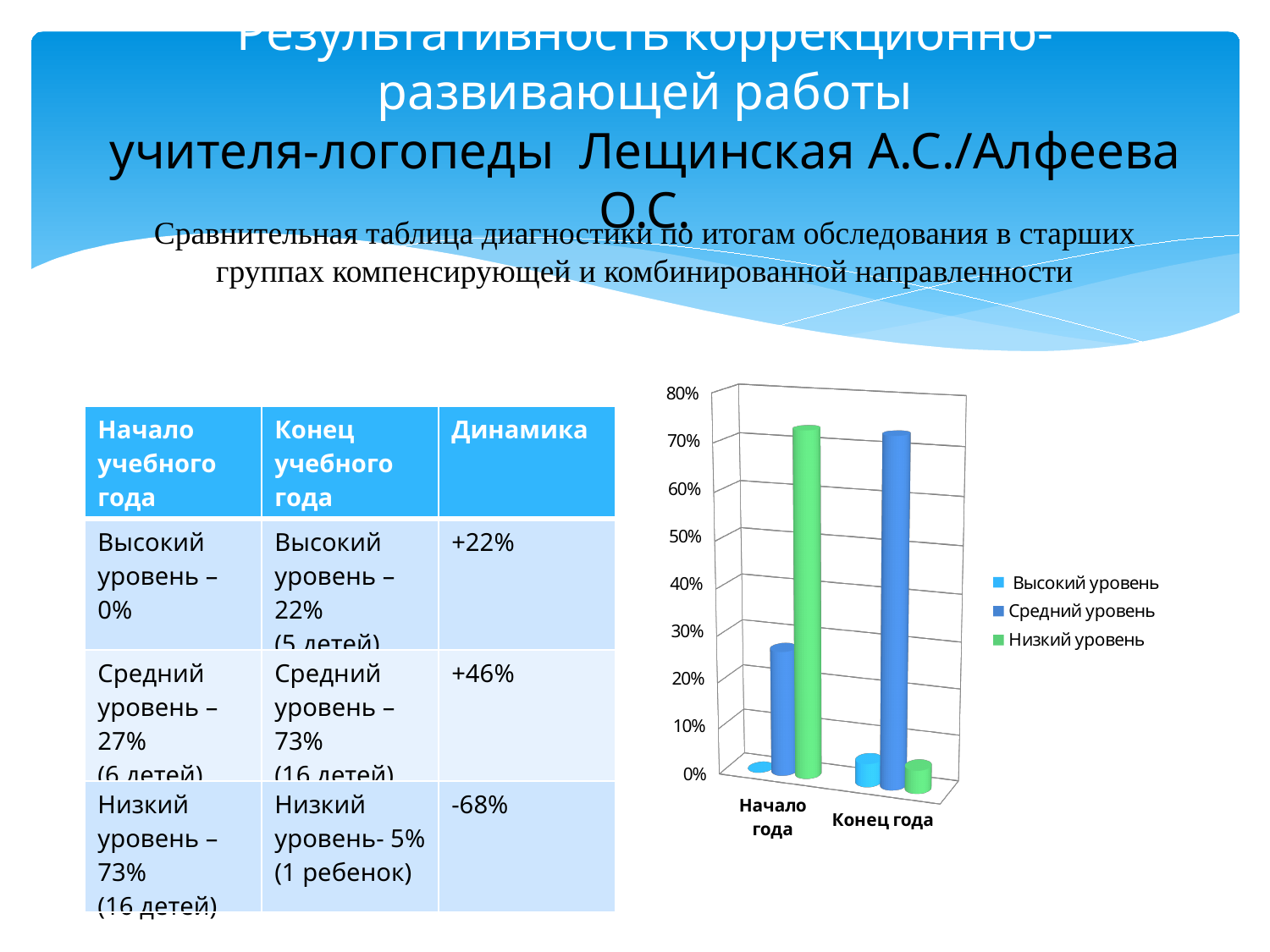
Is the value for Средний уровень at Начало года greater or less than 20%? greater Does the value for Низкий уровень rise or fall from Начало года to Конец года? fall What kind of chart is shown on the slide? bar chart Which series has the tallest bar for Начало года? Низкий уровень Is the value for Низкий уровень at Начало года greater or less than 60%? greater Which series has the tallest bar for Конец года? Средний уровень How many categories are shown on the x axis of the chart? 2 Is the value for Средний уровень larger at Начало года or at Конец года? Конец года What colour are the bars for Низкий уровень in the chart? green Is the value for Низкий уровень at Конец года greater or less than 10%? less Which series has the lowest bar for Начало года? Высокий уровень How many series does the chart legend list? 3